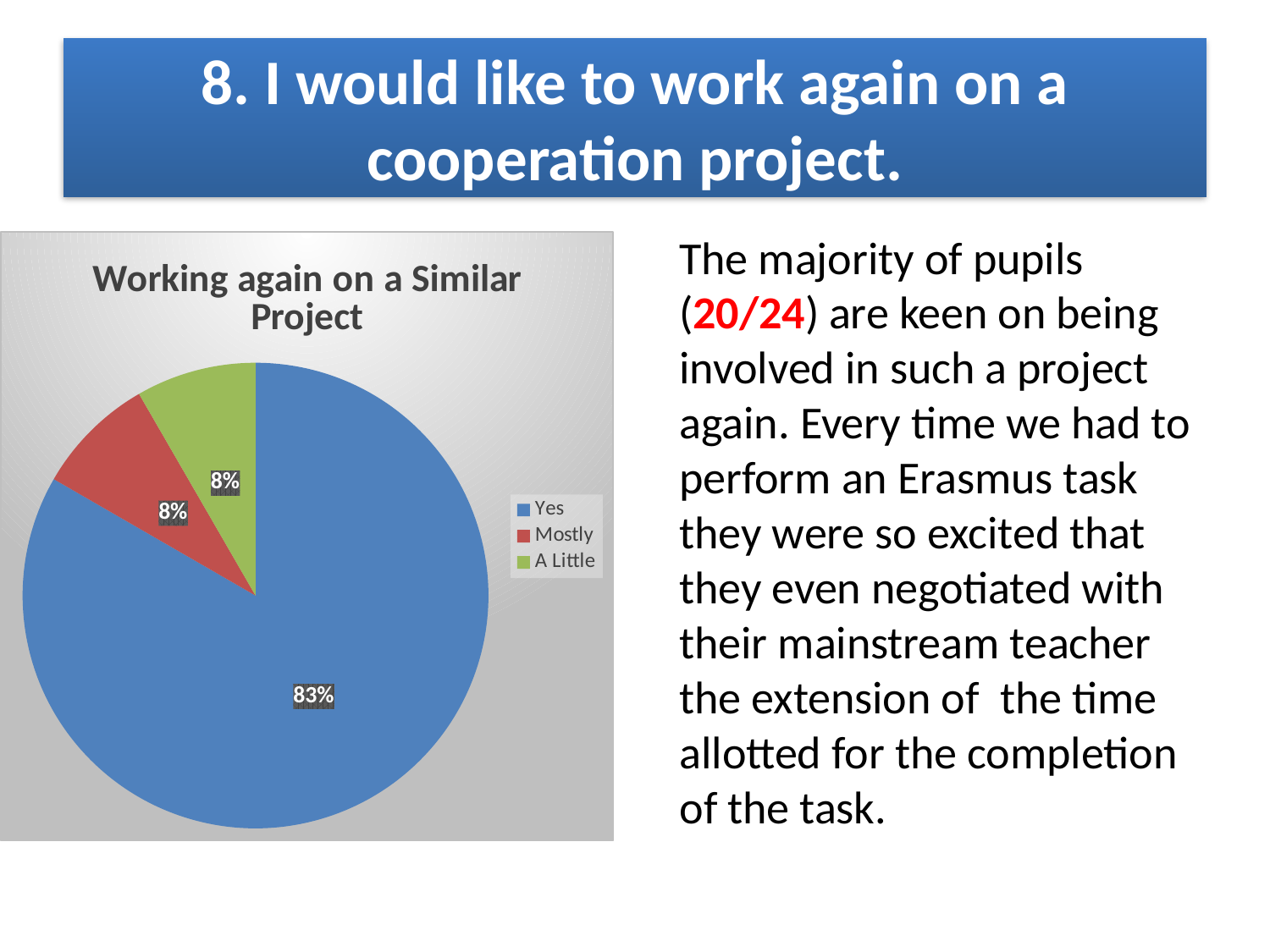
Which colour represents the "Yes" category in the chart? Blue What percentage of the pie is labelled for the "Yes" slice? 83% Is the share for "Yes" greater or less than 50%? greater What is the difference between the "Yes" share and the "A Little" share? 75% How many categories does the legend list? 3 What percentage is shown for the "Mostly" slice? 8% Which category has the largest share of the pie? Yes Which is larger, the share for "Yes" or the share for "Mostly"? Yes What percentage is shown for the "A Little" slice? 8% What is the title of the chart? Working again on a Similar Project What kind of chart is shown on the slide? Pie chart